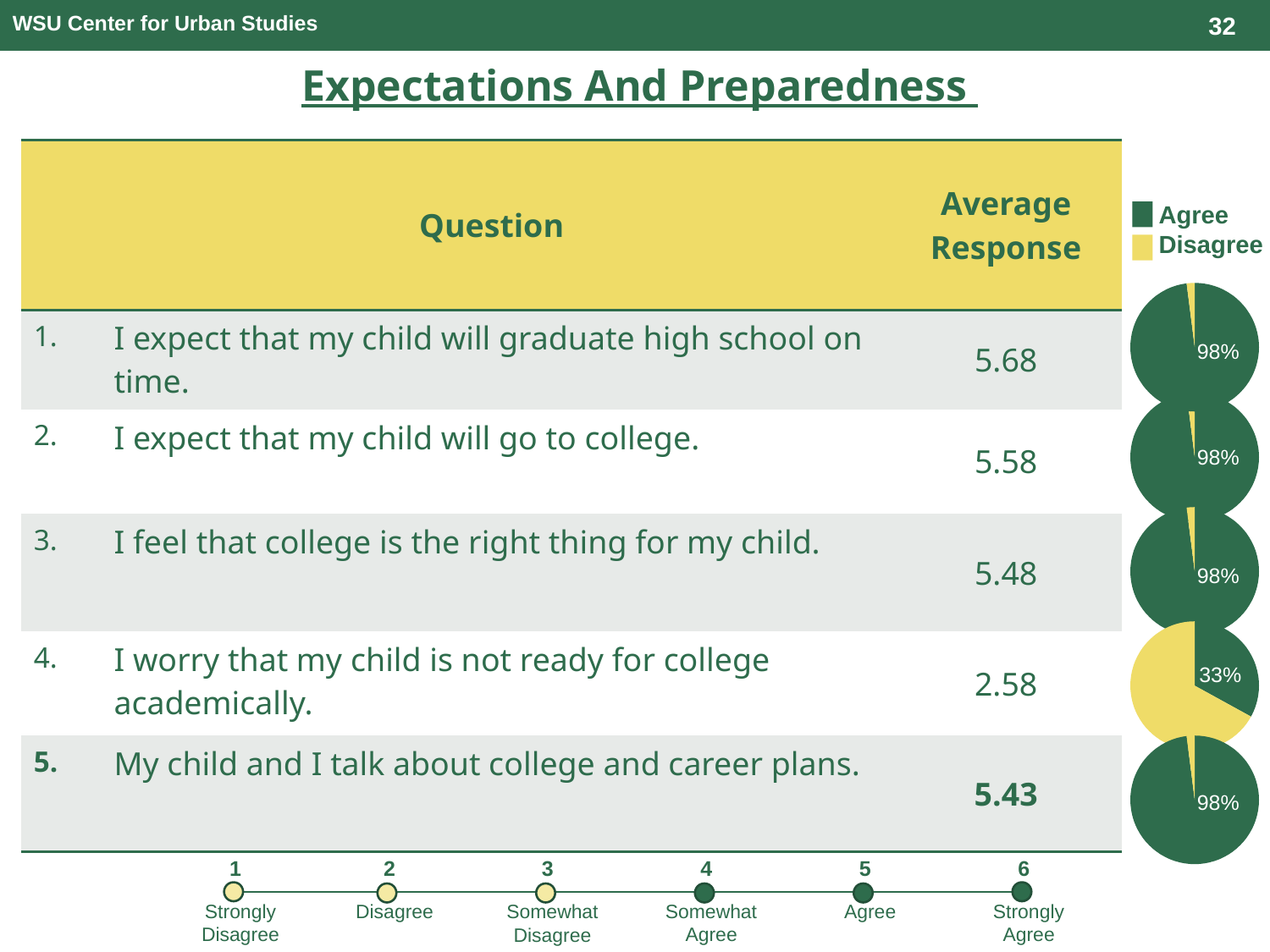
Is the Agree share in the pie chart next to question 3 larger or smaller than the Agree share in the pie chart next to question 4? Larger How many pie charts are on the slide? 5 In the pie chart next to question 1 ("I expect that my child will graduate high school on time"), what share is labelled? 98% Which colour represents Disagree in the pie charts' legend? Yellow Which colour represents Agree in the pie charts' legend? Green What kind of charts are shown on the right side of the slide next to each question? Pie charts Which question's pie chart shows the smallest Agree share? Question 4 How many of the five pie charts are labelled 98%? 4 In the pie chart next to question 4 ("I worry that my child is not ready for college academically"), what share is labelled? 33% How many entries does the legend for the pie charts list? 2 What is the difference between the labelled share in the pie chart for question 1 and the labelled share in the pie chart for question 4? 65% In the pie chart next to question 5 ("My child and I talk about college and career plans"), what share is labelled? 98%